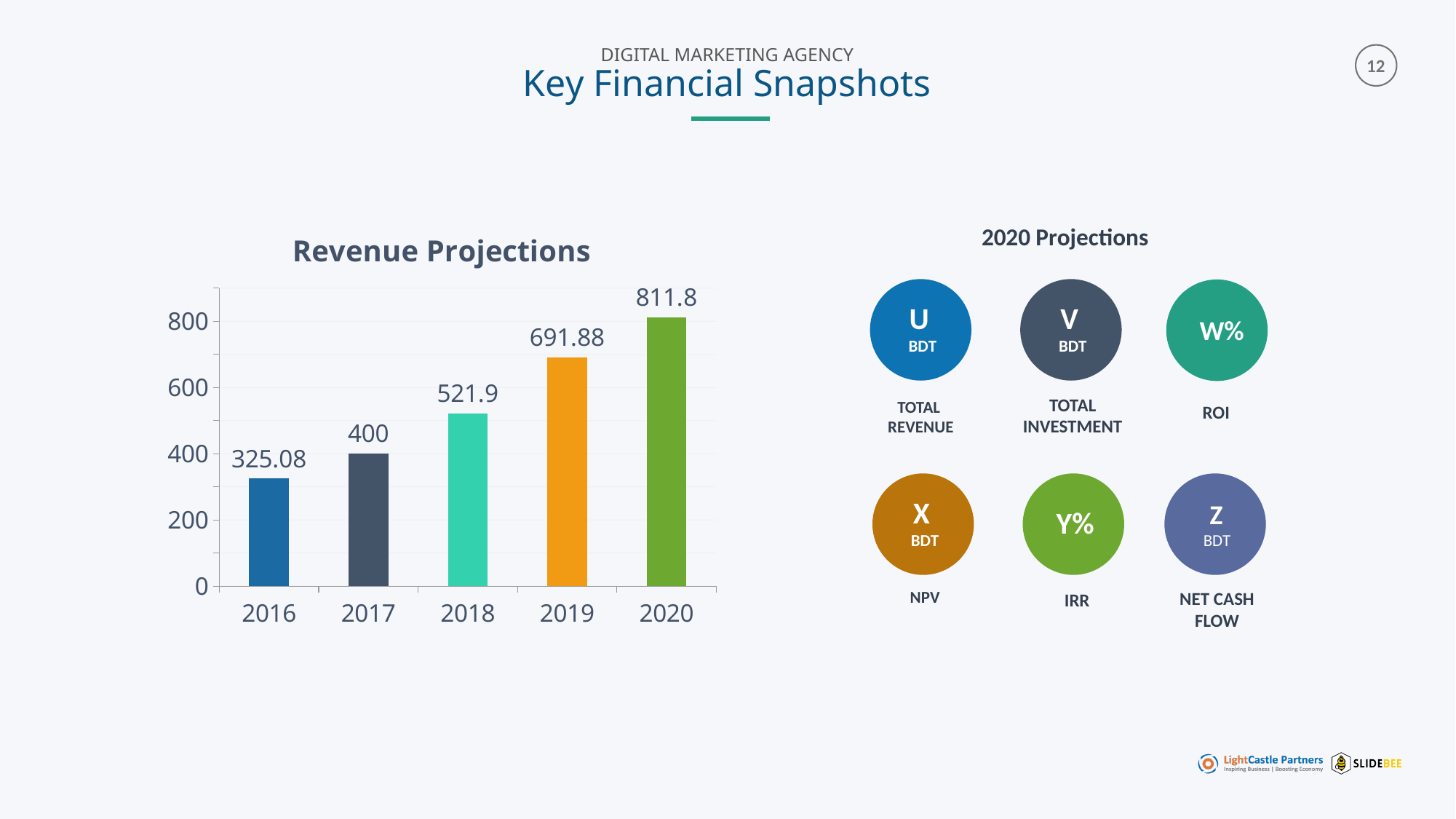
Which year has the highest revenue projection? 2020 Do the revenue projections rise or fall from 2016 to 2020? rise Which year has the lowest revenue projection? 2016 What is the difference between the revenue projections for 2020 and 2019? 119.92 How many years are shown in the Revenue Projections chart? 5 What is the revenue projection for 2016? 325.08 Is the revenue projection for 2019 greater or less than 600? greater What is the difference between the revenue projections for 2017 and 2016? 74.92 What is the revenue projection for 2018? 521.9 What kind of chart is the Revenue Projections chart? bar chart Which year has a larger revenue projection, 2017 or 2018? 2018 What is the revenue projection for 2019? 691.88